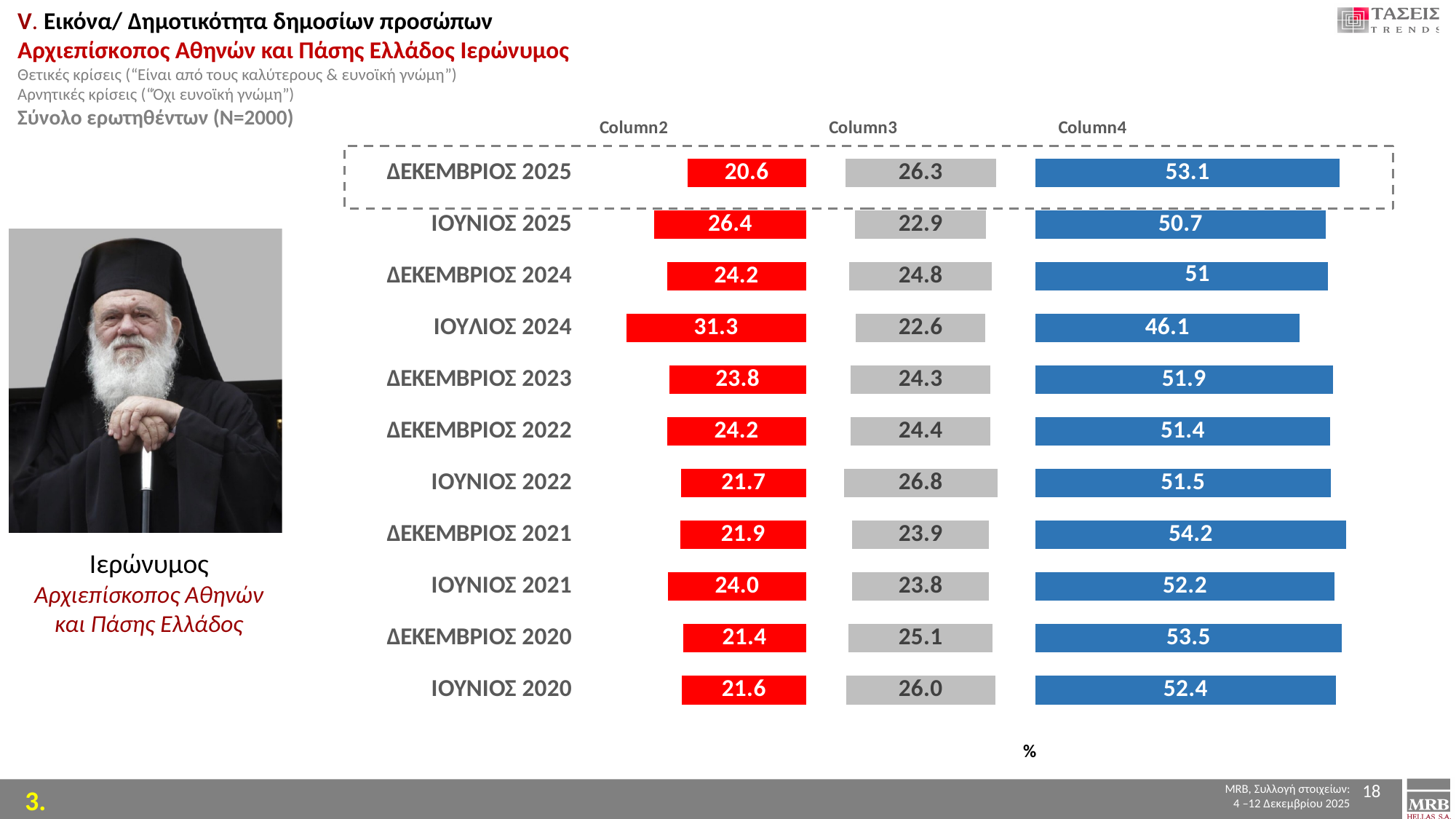
Which period has the highest Column2 value? ΙΟΥΛΙΟΣ 2024 Which period has the lowest Column4 value? ΙΟΥΛΙΟΣ 2024 What is the difference between the Column4 values for ΔΕΚΕΜΒΡΙΟΣ 2025 and ΙΟΥΝΙΟΣ 2025? 2.4 How many series does the chart show? 3 What is the difference between the Column2 values for ΙΟΥΛΙΟΣ 2024 and ΔΕΚΕΜΒΡΙΟΣ 2024? 7.1 Which period has the highest Column4 value? ΔΕΚΕΜΒΡΙΟΣ 2021 What is the Column4 value for ΙΟΥΛΙΟΣ 2024? 46.1 What is the Column3 value for ΙΟΥΝΙΟΣ 2022? 26.8 What kind of chart is shown on the slide? Bar chart What is the Column2 value for ΔΕΚΕΜΒΡΙΟΣ 2025? 20.6 How many time periods are shown in the chart? 11 Which is larger: the Column2 value for ΙΟΥΝΙΟΣ 2025 or the Column2 value for ΔΕΚΕΜΒΡΙΟΣ 2025? ΙΟΥΝΙΟΣ 2025